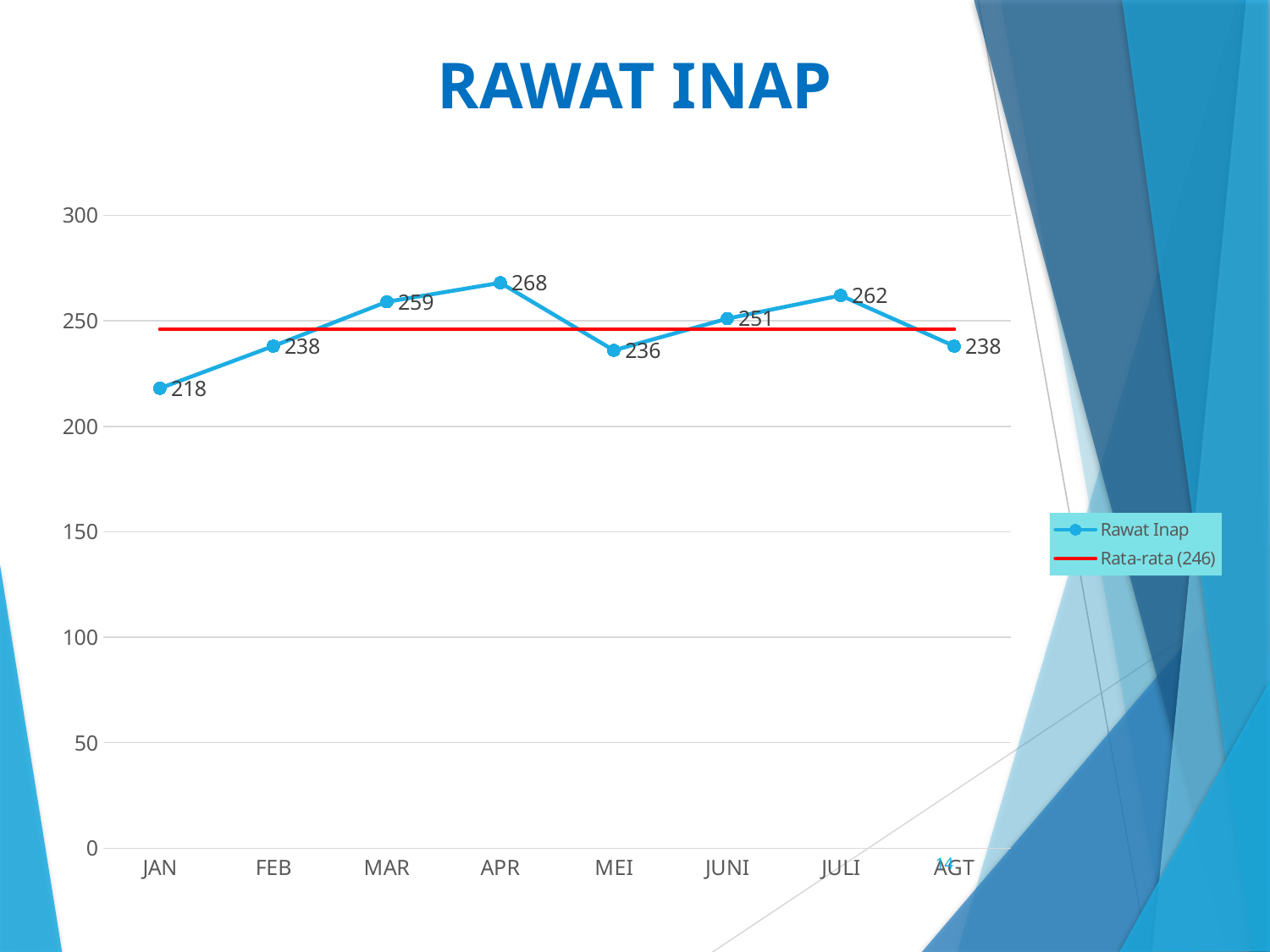
What is the Rawat Inap value for APR? 268 Which is larger, the Rawat Inap value for MAR or for JUNI? MAR Is the Rawat Inap value for MEI greater or less than 250? less How many months are plotted on the x axis? 8 What is the difference between the Rawat Inap values for APR and JAN? 50 Which month has the highest Rawat Inap value? APR What is the Rawat Inap value for JAN? 218 What kind of chart is shown on the slide? line chart How many series does the legend list? 2 Which month has the lowest Rawat Inap value? JAN What value does the legend give for the Rata-rata line? 246 What is the Rawat Inap value for JULI? 262